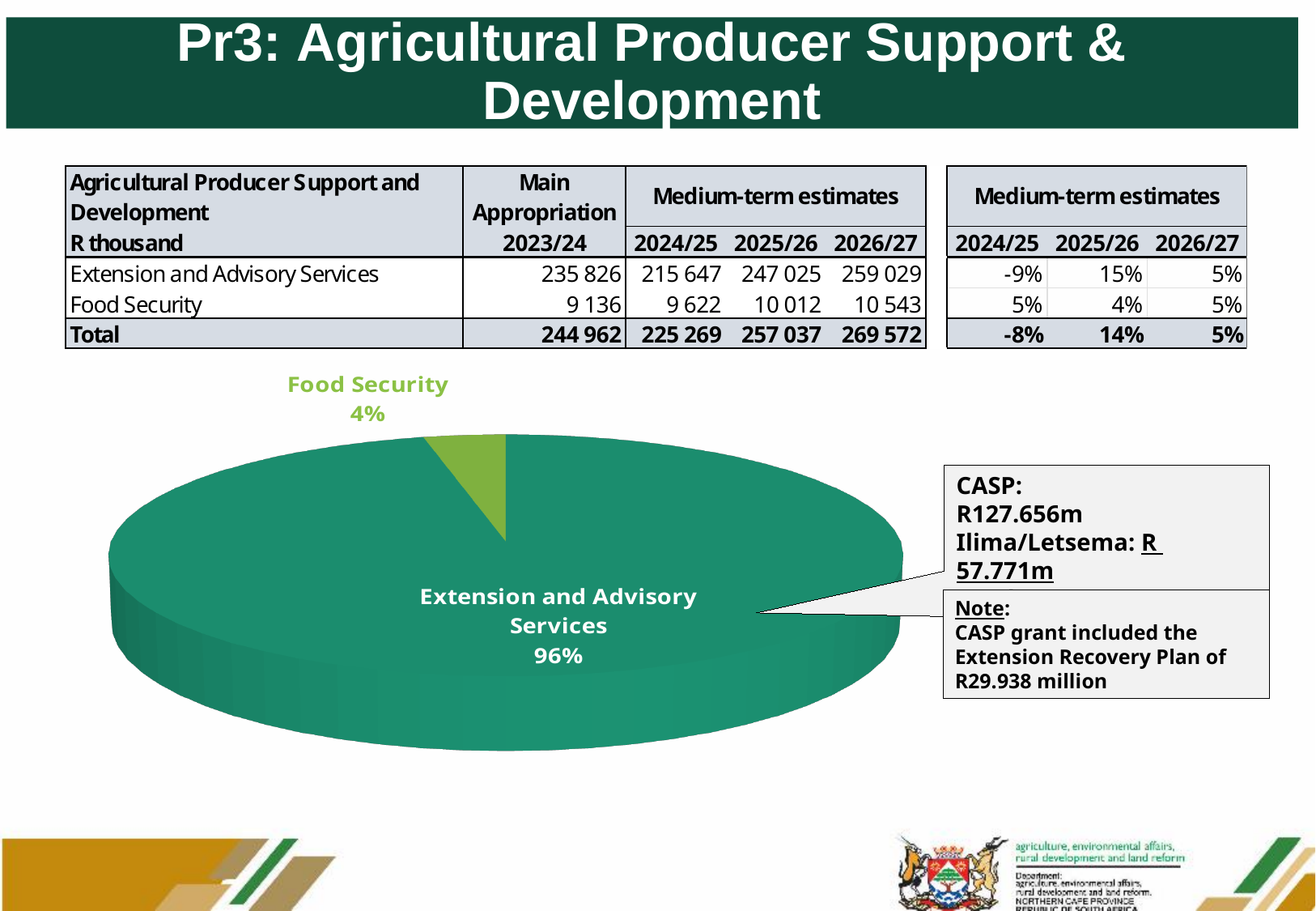
By how many percentage points does the Extension and Advisory Services share exceed the Food Security share? 92 Which is larger in the pie chart, Food Security or Extension and Advisory Services? Extension and Advisory Services Is the share for Food Security greater or less than 10%? less What colour is the Food Security slice in the pie chart? light green Which slice of the pie chart is the smallest? Food Security What kind of chart is shown on the slide? pie chart What is the CASP amount shown in the callout box next to the pie chart? R127.656m How many slices does the pie chart have? 2 What share of the pie does Extension and Advisory Services take? 96% What share of the pie does Food Security take? 4% Which slice of the pie chart is the largest? Extension and Advisory Services